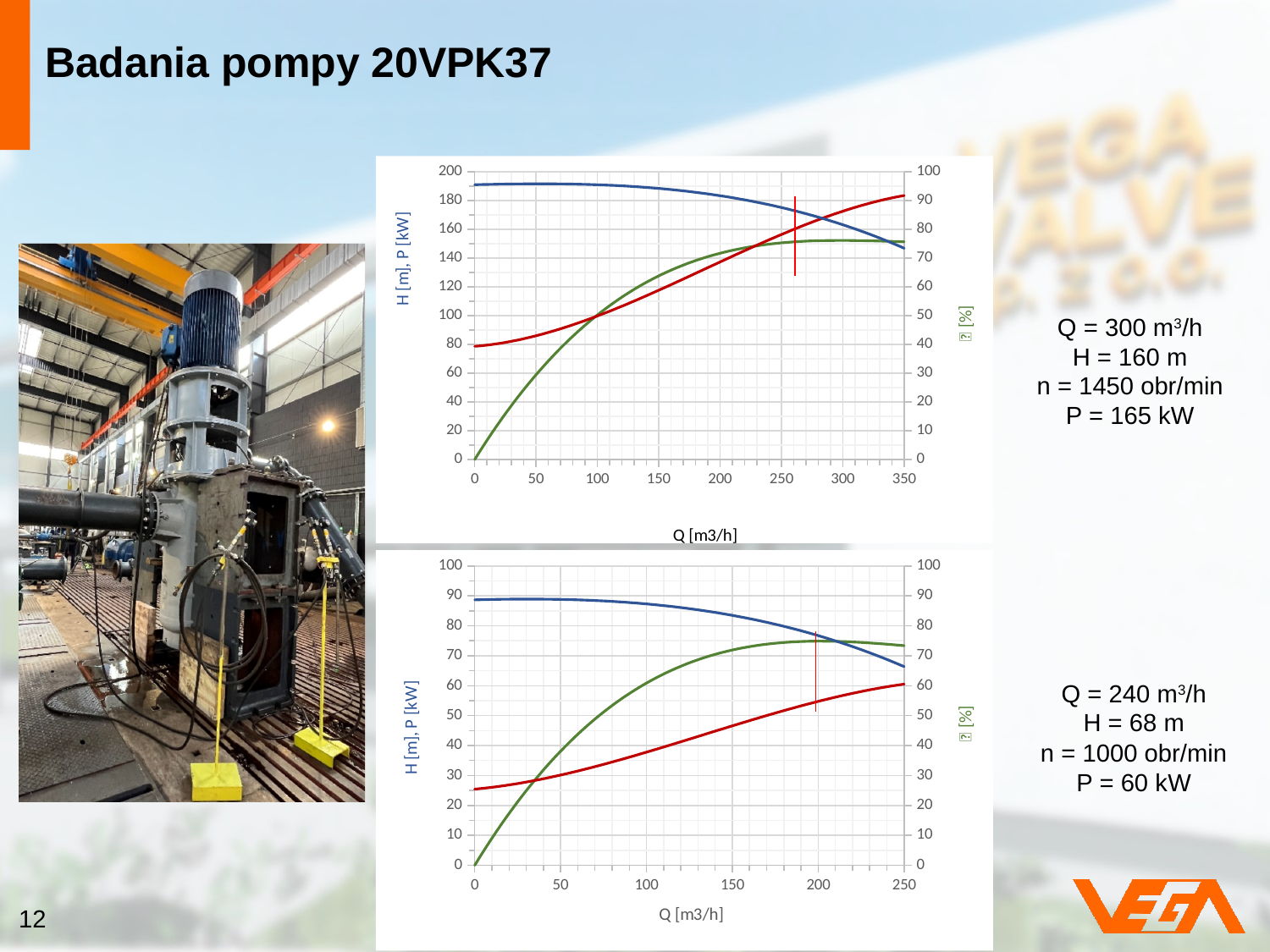
In the bottom chart, what is the label of the horizontal axis? Q [m3/h] In the top chart, does the red line rise or fall as Q increases? rise What kind of chart is the top chart on the slide? line chart In the top chart, what is the label of the left vertical axis? H [m], P [kW] What kind of chart is the bottom chart on the slide? line chart In the top chart, is the value of the red line at Q = 0 greater or less than 100 on the left axis? less In the top chart, is the value of the blue line at Q = 350 greater or less than 180 on the left axis? less In the bottom chart, does the red line rise or fall as Q increases? rise In the top chart, does the blue line rise or fall as Q increases? fall In the bottom chart, is the value of the blue line at Q = 0 greater or less than 80 on the left axis? greater